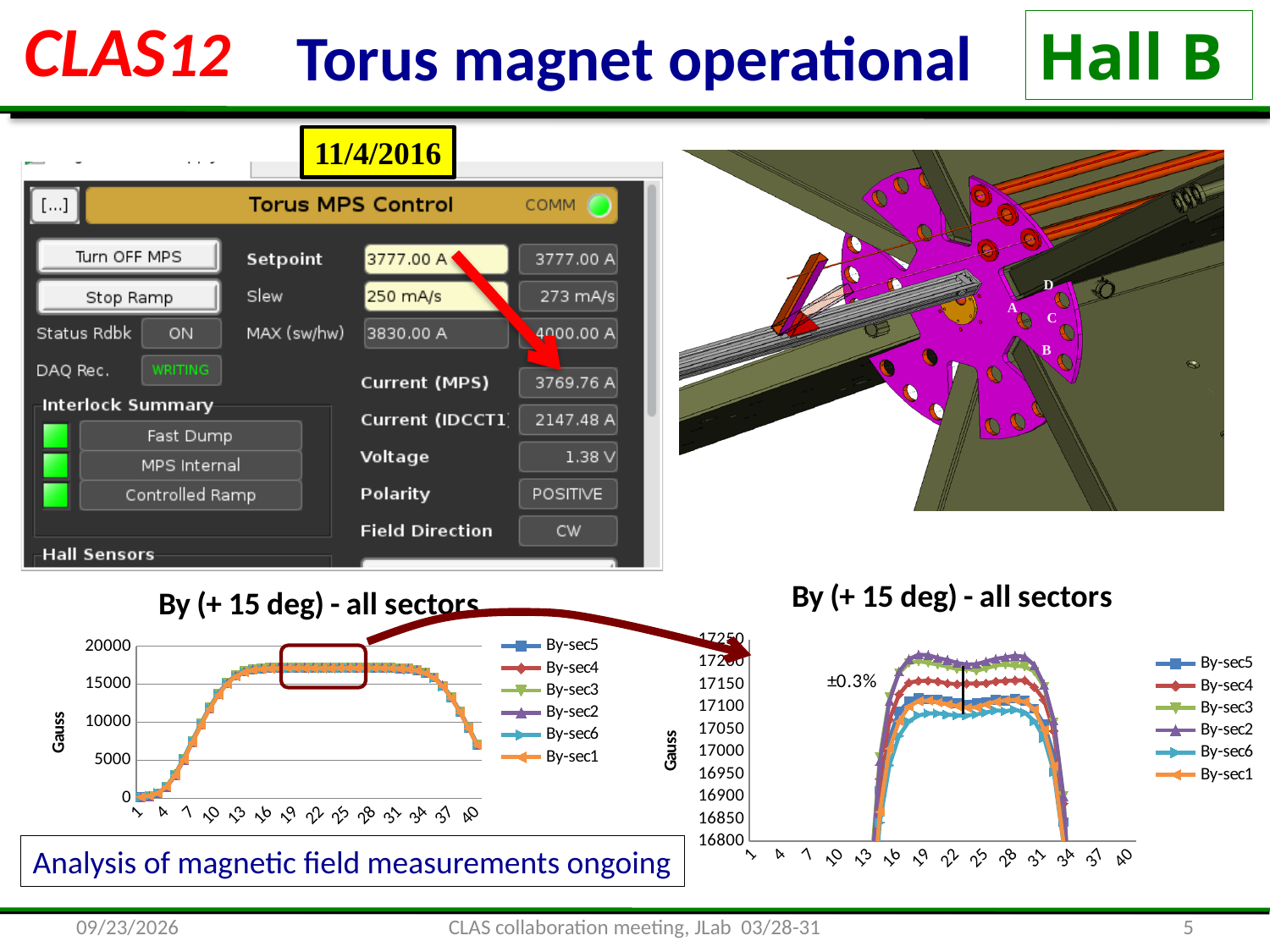
In the right chart, is the value for By-sec2 at x = 22 greater or less than 17150? greater In the left chart, is the value for By-sec1 at x = 1 greater or less than 5000? less In the left chart, is the value for By-sec1 at x = 22 greater or less than 15000? greater In the left chart, do the values rise or fall along the x axis from x = 1 to x = 13? rise In the right chart, at x = 22, which is larger: By-sec2 or By-sec6? By-sec2 How many series does the legend of the left chart list? 6 How many series does the legend of the right chart list? 6 In the right chart, which series has the highest value at x = 22? By-sec2 What is the y-axis label on the left chart? Gauss What percentage annotation is printed inside the right chart? ±0.3% What type of chart is the left 'By (+ 15 deg) - all sectors' chart? line chart